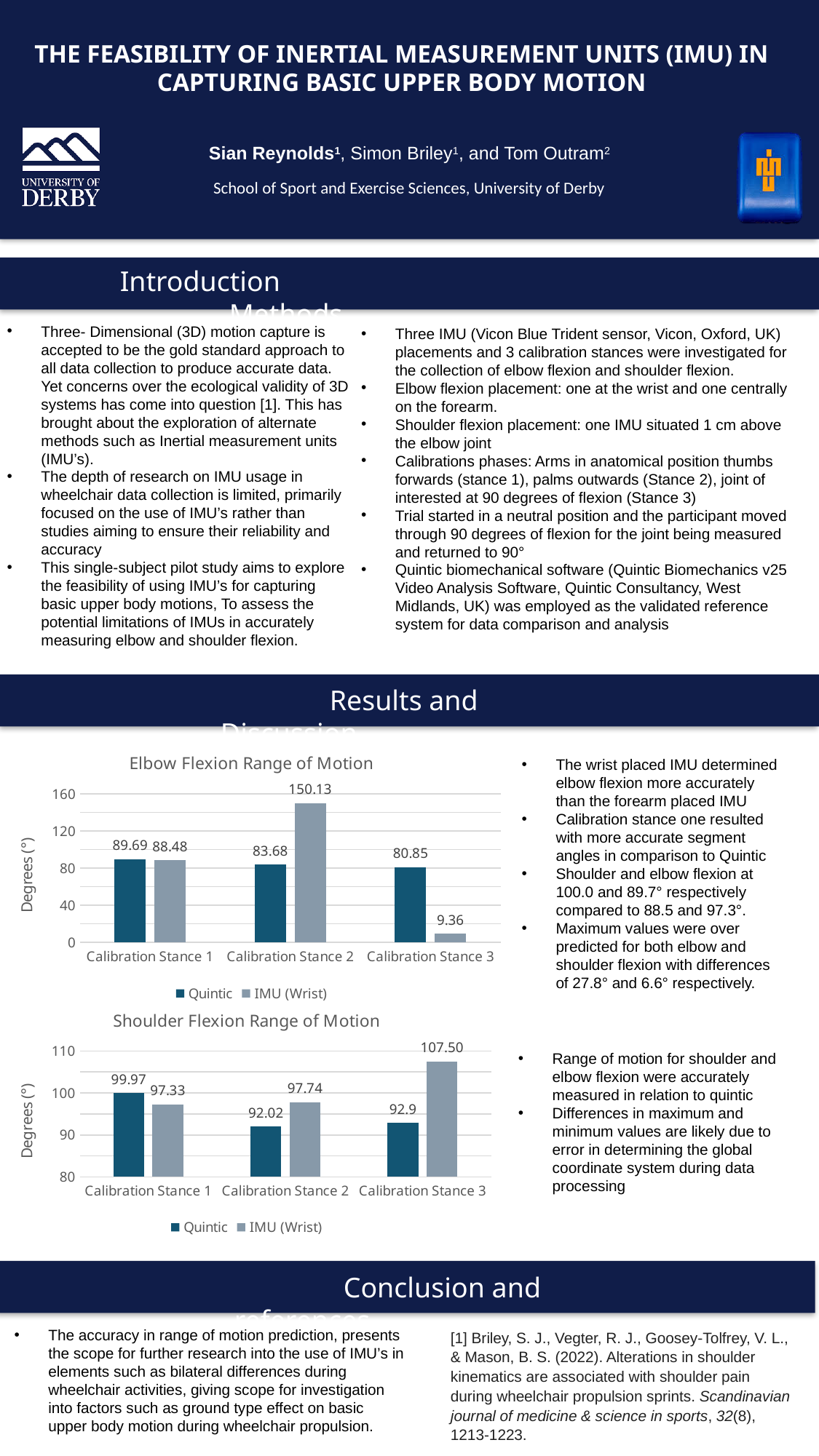
How many series does the legend of the Elbow Flexion Range of Motion chart list? 2 In the Shoulder Flexion Range of Motion chart, which is larger for Calibration Stance 2: the Quintic value or the IMU (Wrist) value? IMU (Wrist) In the Elbow Flexion Range of Motion chart, which calibration stance has the lowest IMU (Wrist) value? Calibration Stance 3 In the Elbow Flexion Range of Motion chart, what is the Quintic value for Calibration Stance 3? 80.85 In the Elbow Flexion Range of Motion chart, what is the IMU (Wrist) value for Calibration Stance 2? 150.13 In the Shoulder Flexion Range of Motion chart, which calibration stance has the highest Quintic value? Calibration Stance 1 In the Elbow Flexion Range of Motion chart, is the IMU (Wrist) value for Calibration Stance 2 greater or less than 120? greater In the Shoulder Flexion Range of Motion chart, what is the difference between the IMU (Wrist) and Quintic values for Calibration Stance 3? 14.6 In the Shoulder Flexion Range of Motion chart, what is the IMU (Wrist) value for Calibration Stance 3? 107.50 In the Elbow Flexion Range of Motion chart, what is the difference between the Quintic and IMU (Wrist) values for Calibration Stance 1? 1.21 What type of chart is the Shoulder Flexion Range of Motion chart? Bar chart In the Shoulder Flexion Range of Motion chart, what is the Quintic value for Calibration Stance 1? 99.97